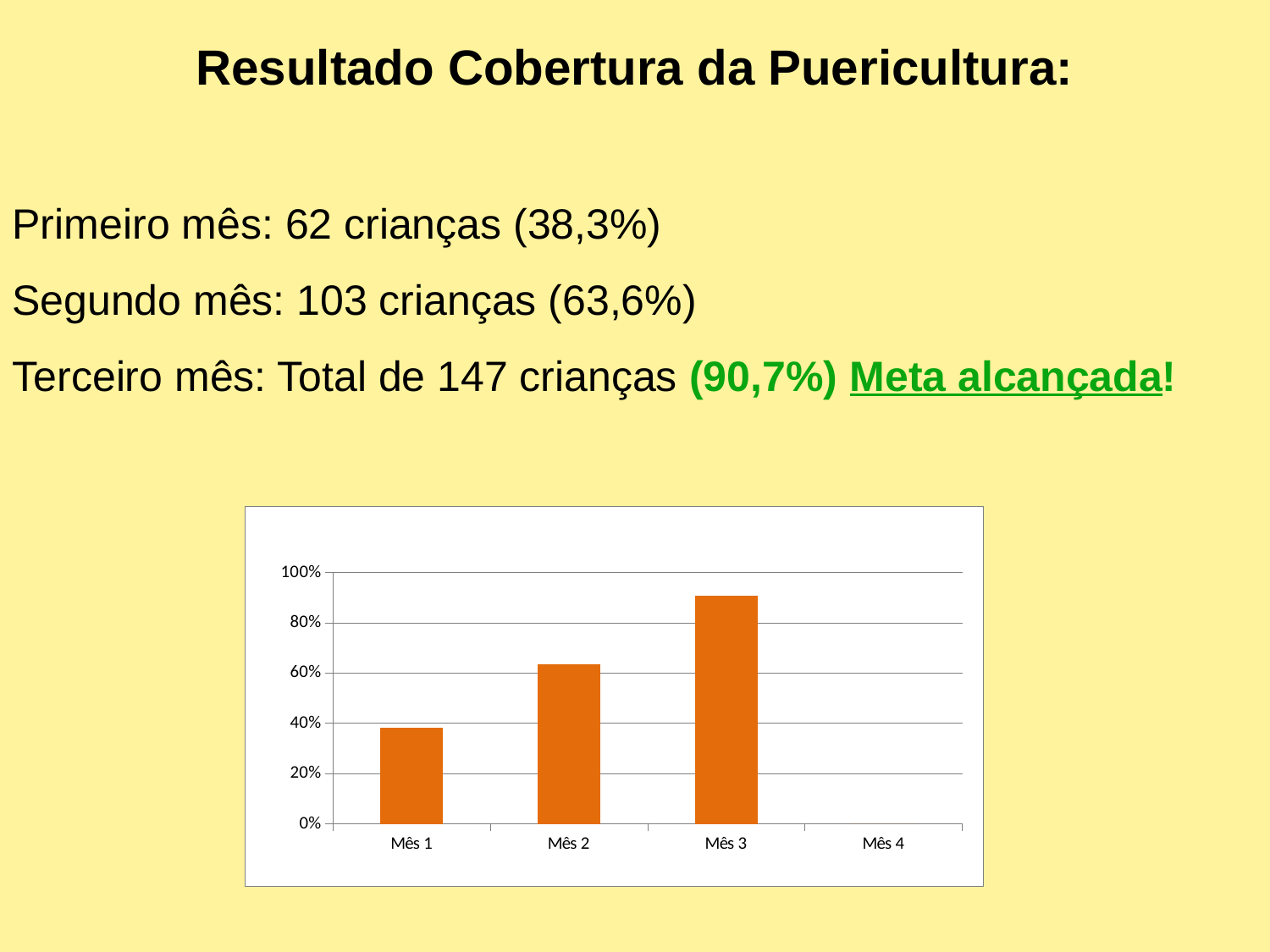
Which month has the tallest bar in the chart? Mês 3 Is the value for Mês 1 greater or less than 20%? greater Which is larger, the bar for Mês 2 or the bar for Mês 1? Mês 2 Is the value for Mês 3 greater or less than 80%? greater What colour are the bars in the chart? orange Is the value for Mês 1 greater or less than 40%? less Which month on the x axis has no visible bar? Mês 4 What kind of chart is shown on the slide? bar chart What is the highest value shown on the chart's vertical axis? 100% Do the bar values rise or fall from Mês 1 to Mês 3? rise How many categories are shown on the x axis of the chart? 4